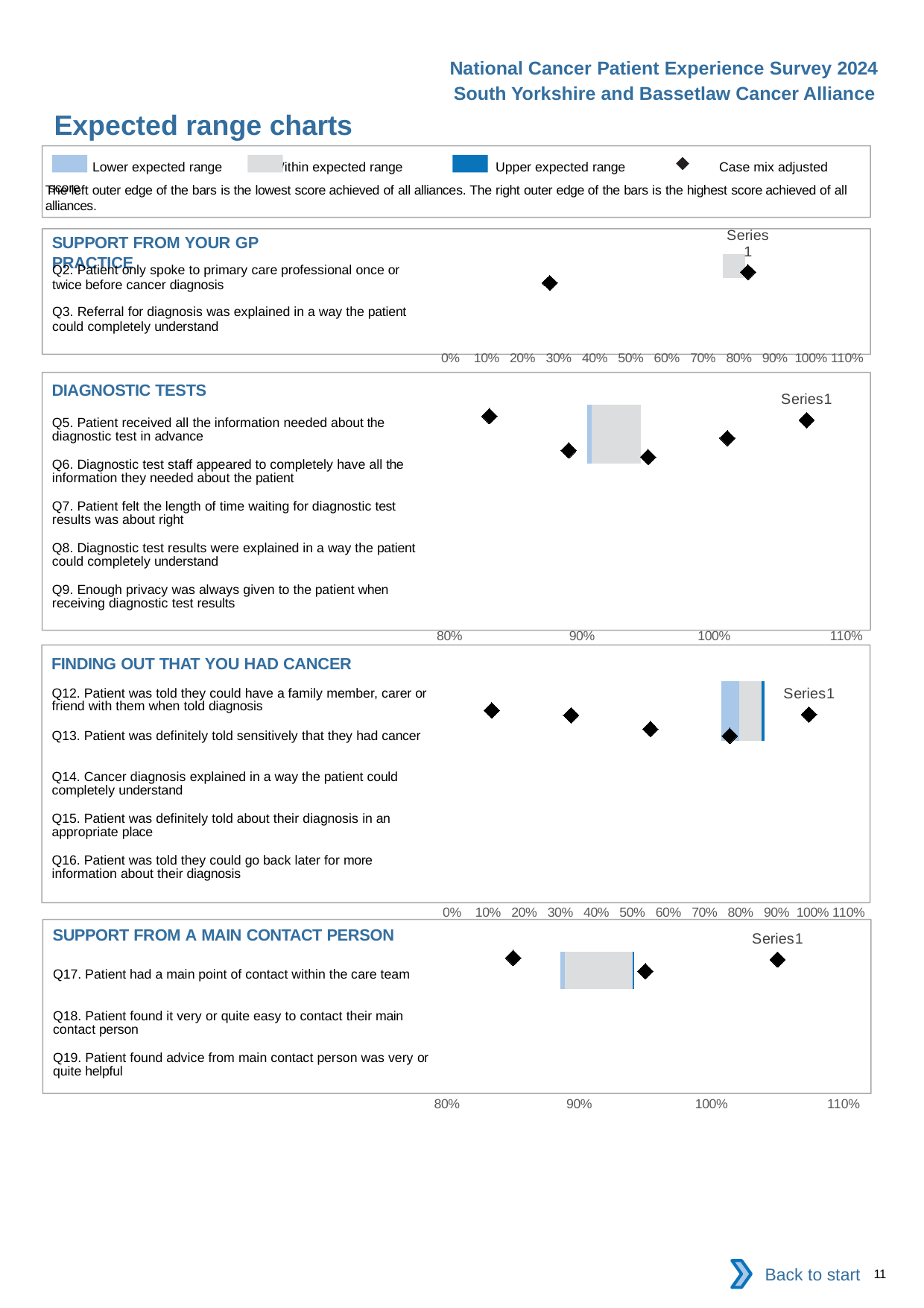
How many question labels are listed in the 'FINDING OUT THAT YOU HAD CANCER' chart? 5 In the 'FINDING OUT THAT YOU HAD CANCER' chart, is the leftmost plotted marker greater or less than 20%? less In the 'SUPPORT FROM A MAIN CONTACT PERSON' chart, is the leftmost plotted marker greater or less than 90%? less How many question labels are listed in the 'DIAGNOSTIC TESTS' chart? 5 In the 'FINDING OUT THAT YOU HAD CANCER' chart, what is the highest value shown on the x axis? 110% How many question labels are listed in the 'SUPPORT FROM YOUR GP PRACTICE' chart? 2 According to the slide's legend, what does the diamond marker represent? Case mix adjusted score What is the name of the series shown in the legend of the 'DIAGNOSTIC TESTS' chart? Series1 How many series does the legend of the 'SUPPORT FROM A MAIN CONTACT PERSON' chart list? 1